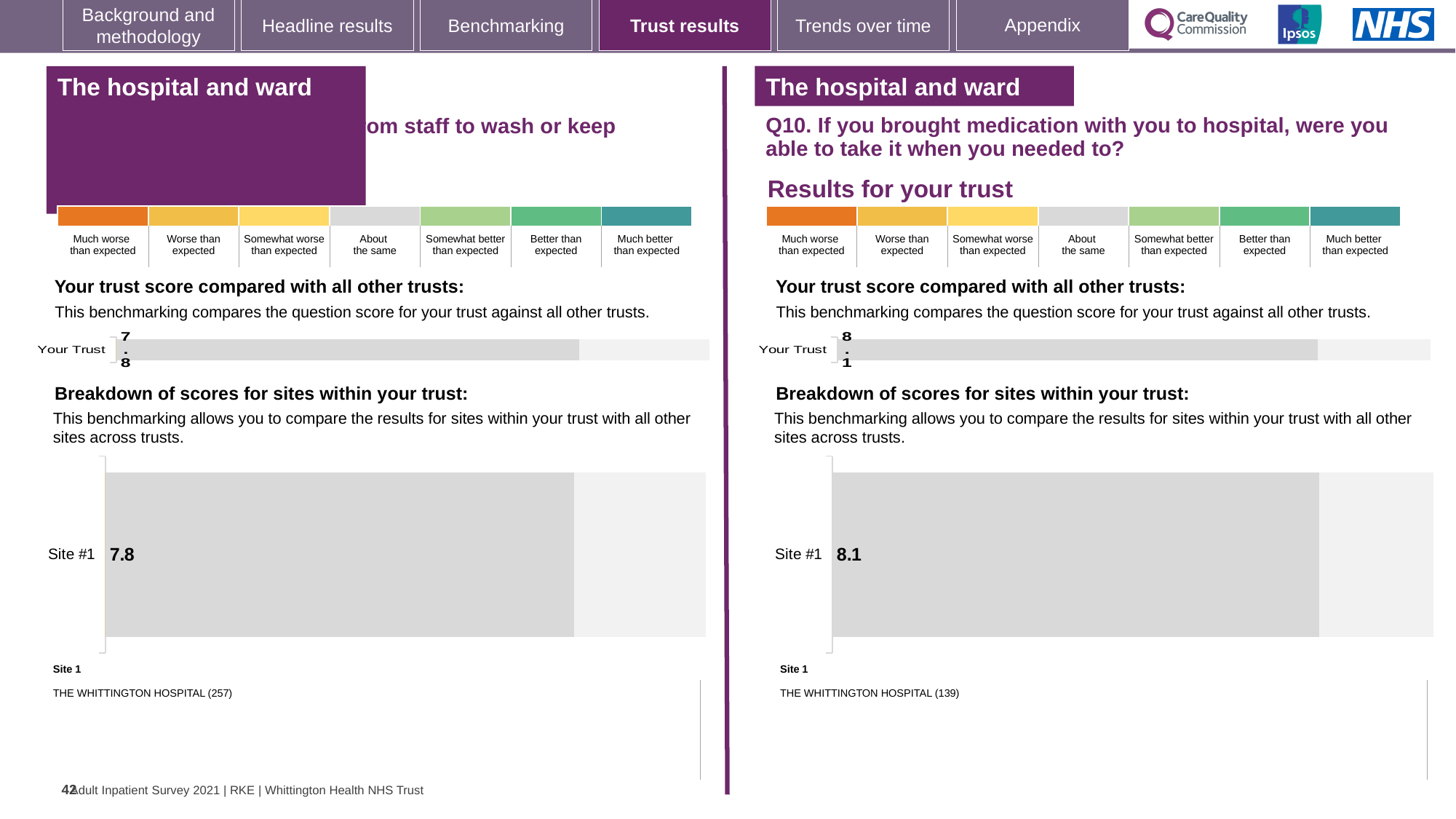
Which is larger: the Site #1 score on the right half of the slide (Q10) or the Site #1 score on the left half of the slide? Site #1 on the right half (Q10) On the right half of the slide (Q10), which site is listed as Site 1? THE WHITTINGTON HOSPITAL (139) On the left half of the slide, what is the score shown for Your Trust? 7.8 On the right half of the slide (Q10, medication), what is the score shown for Site #1? 8.1 On the left half of the slide, what is the score shown for Site #1? 7.8 On the right half of the slide (Q10, medication), what is the score shown for Your Trust? 8.1 What is the difference between the Site #1 score on the right half of the slide (Q10) and the Site #1 score on the left half of the slide? 0.3 On the left half of the slide, which site is listed as Site 1? THE WHITTINGTON HOSPITAL (257) What type of chart is used to show the Site #1 score on the right half of the slide (Q10)? Bar chart How many sites are shown in the site breakdown chart on the right half of the slide (Q10)? 1 How many sites are shown in the site breakdown chart on the left half of the slide? 1